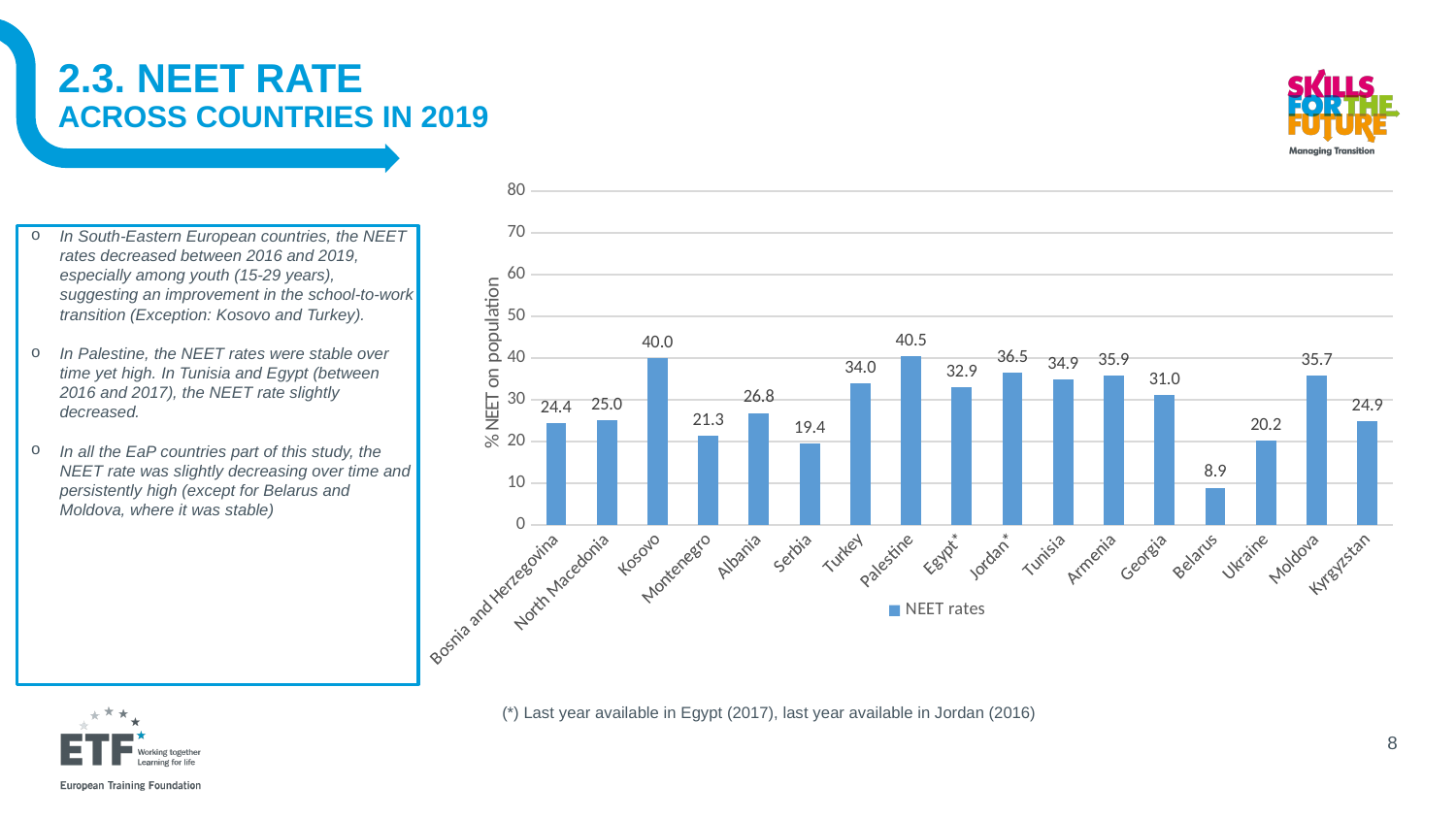
Which country has the highest NEET rate? Palestine What is the NEET rate for Serbia? 19.4 How many countries are shown in the chart? 17 Which has a higher NEET rate, Armenia or Georgia? Armenia What is the NEET rate for Moldova? 35.7 What is the difference between the NEET rates of Turkey and Montenegro? 12.7 How many series does the legend list? 1 What type of chart is shown on the slide? bar chart Is the NEET rate for Ukraine greater or less than 30? less What is the NEET rate for Kosovo? 40.0 Which country has the lowest NEET rate? Belarus What is the NEET rate for Belarus? 8.9